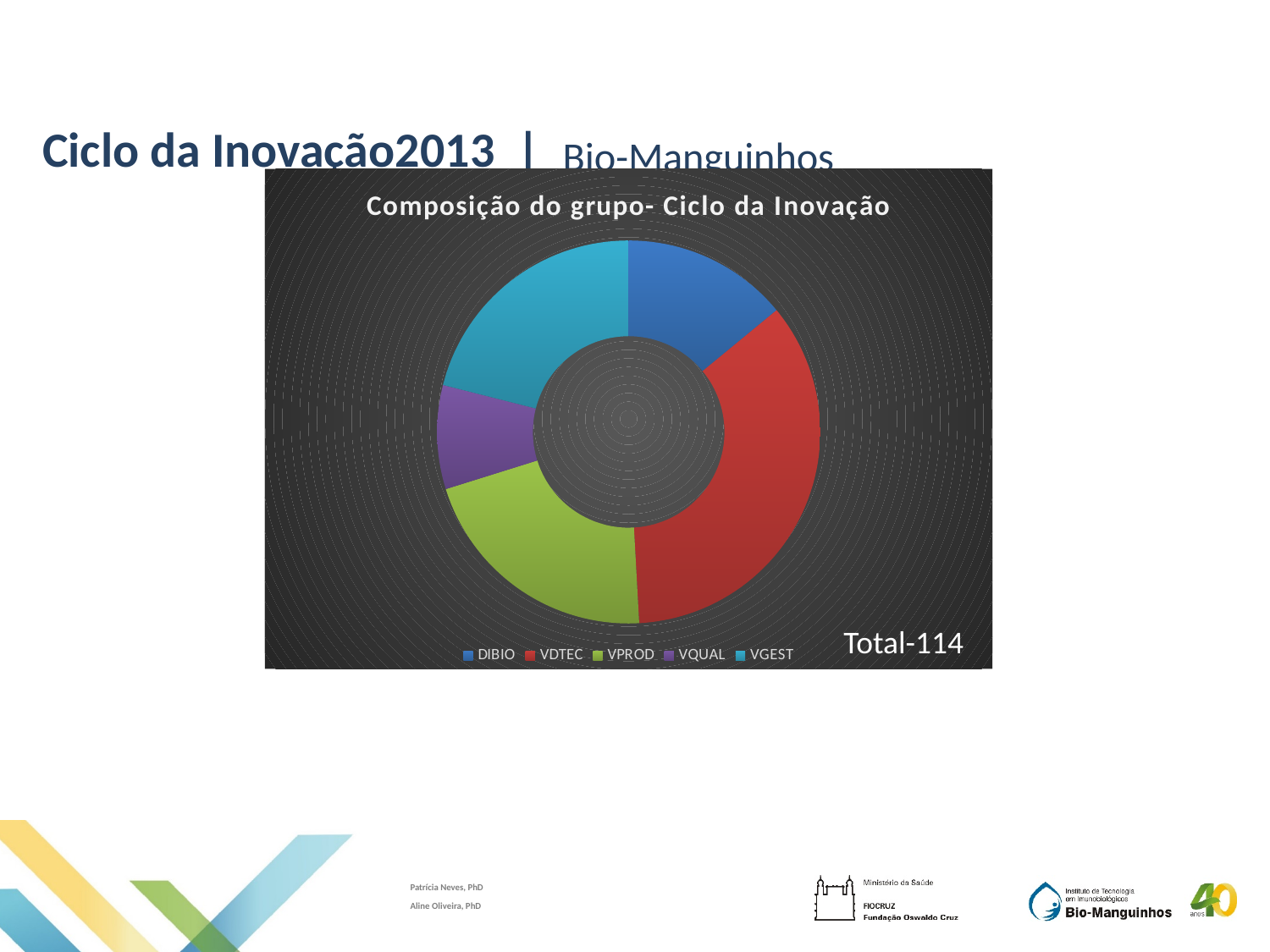
Which colour represents VDTEC in the chart? red Which slice is larger, VGEST or DIBIO? VGEST Which slice is larger, VDTEC or DIBIO? VDTEC Which slice is larger, VPROD or VQUAL? VPROD Which category has the largest slice in the chart? VDTEC What total is printed on the chart? 114 Which category has the smallest slice in the chart? VQUAL What is the title of the chart? Composição do grupo- Ciclo da Inovação How many categories does the chart's legend list? 5 What kind of chart is shown on the slide? doughnut chart